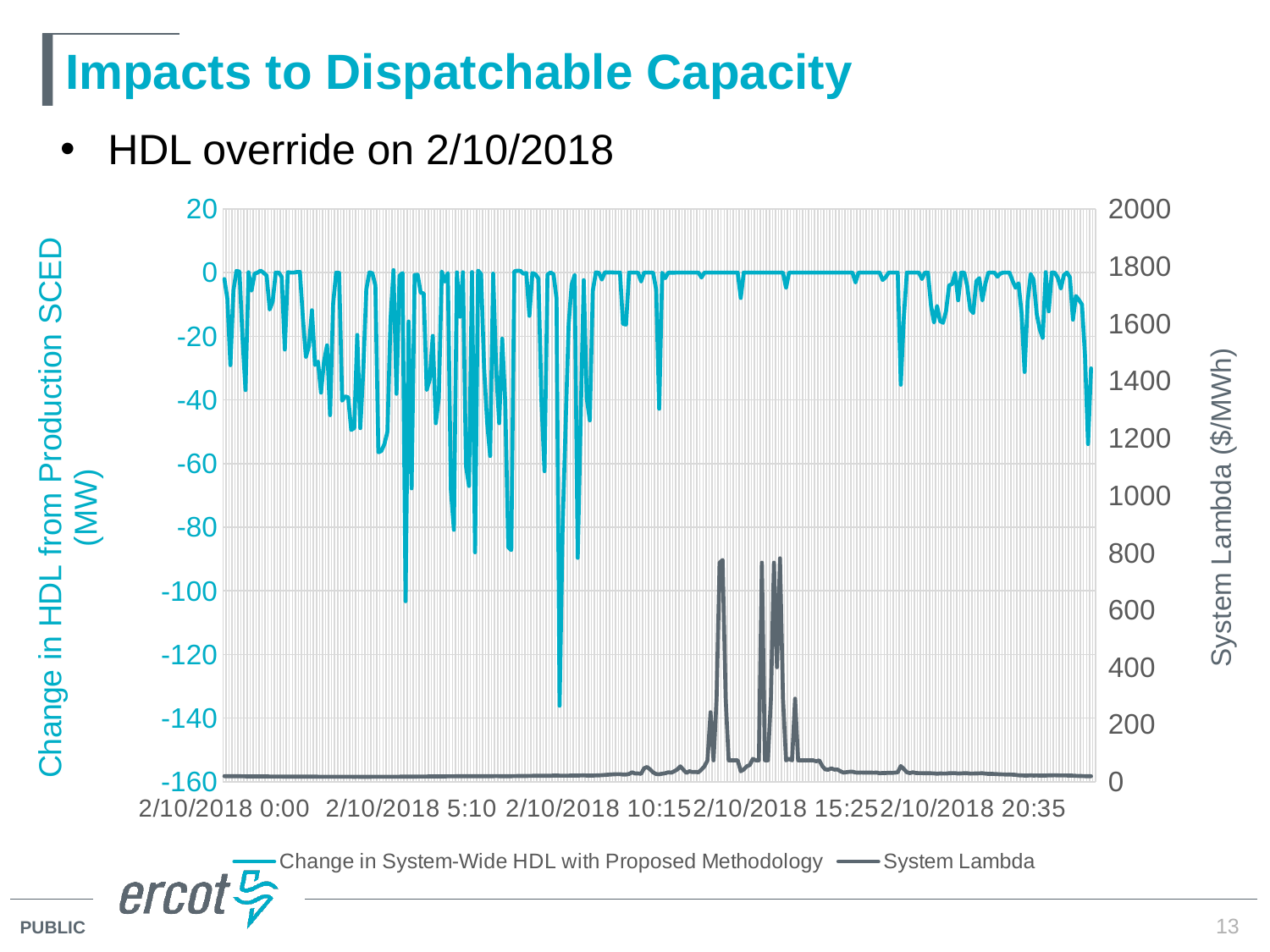
Is the highest value of the System Lambda series greater or less than 1000? less What kind of chart is shown on the slide? line chart What is the first time label on the x axis? 2/10/2018 0:00 How many time labels are shown on the x axis? 5 What is the title of the left vertical axis? Change in HDL from Production SCED (MW) What is the maximum value shown on the right vertical axis? 2000 Is the lowest value of the Change in System-Wide HDL series greater or less than -120? less How many series does the legend list? 2 Is the highest value of the Change in System-Wide HDL series greater or less than 20? less Which series is plotted in teal according to the legend? Change in System-Wide HDL with Proposed Methodology